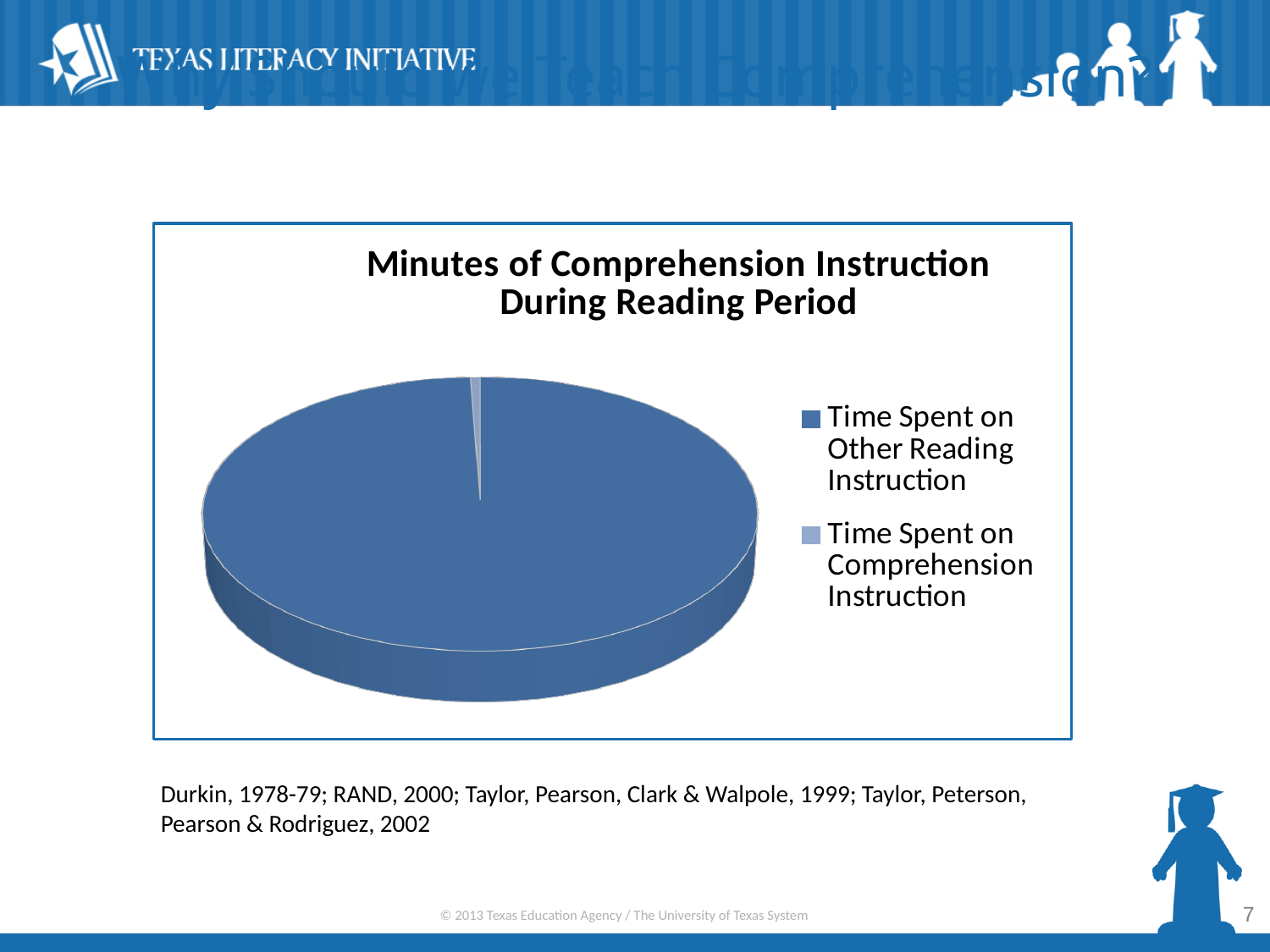
How many slices does the pie chart have? 2 Which is larger: the slice for Time Spent on Other Reading Instruction or the slice for Time Spent on Comprehension Instruction? Time Spent on Other Reading Instruction How many entries does the legend list? 2 Which slice is the largest in the pie chart? Time Spent on Other Reading Instruction What kind of chart is shown on the slide? Pie chart Which slice is the smallest in the pie chart? Time Spent on Comprehension Instruction What is the title of the chart? Minutes of Comprehension Instruction During Reading Period Which legend entry is shown in the lighter blue colour? Time Spent on Comprehension Instruction